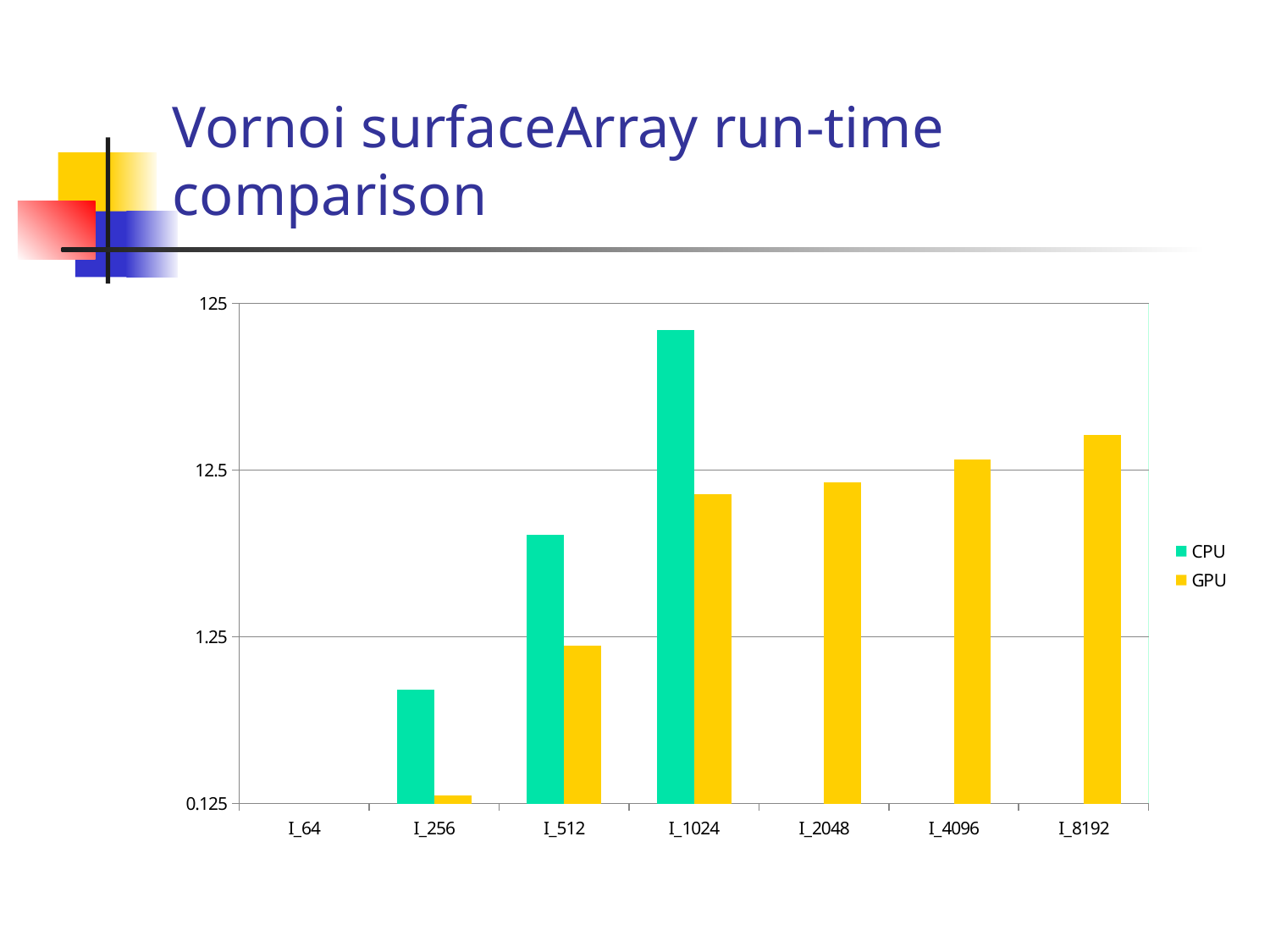
Do the GPU values rise or fall from I_256 to I_8192? rise Which category has the highest GPU value? I_8192 Is the GPU value for I_1024 greater or less than 12.5? less Is the CPU value for I_512 greater or less than 1.25? greater Is the GPU value for I_8192 greater or less than 12.5? greater For I_1024, which is larger, the CPU value or the GPU value? CPU Which category has the highest CPU value? I_1024 How many categories are shown on the x axis? 7 What kind of chart is shown on the slide? bar chart How many series does the legend list? 2